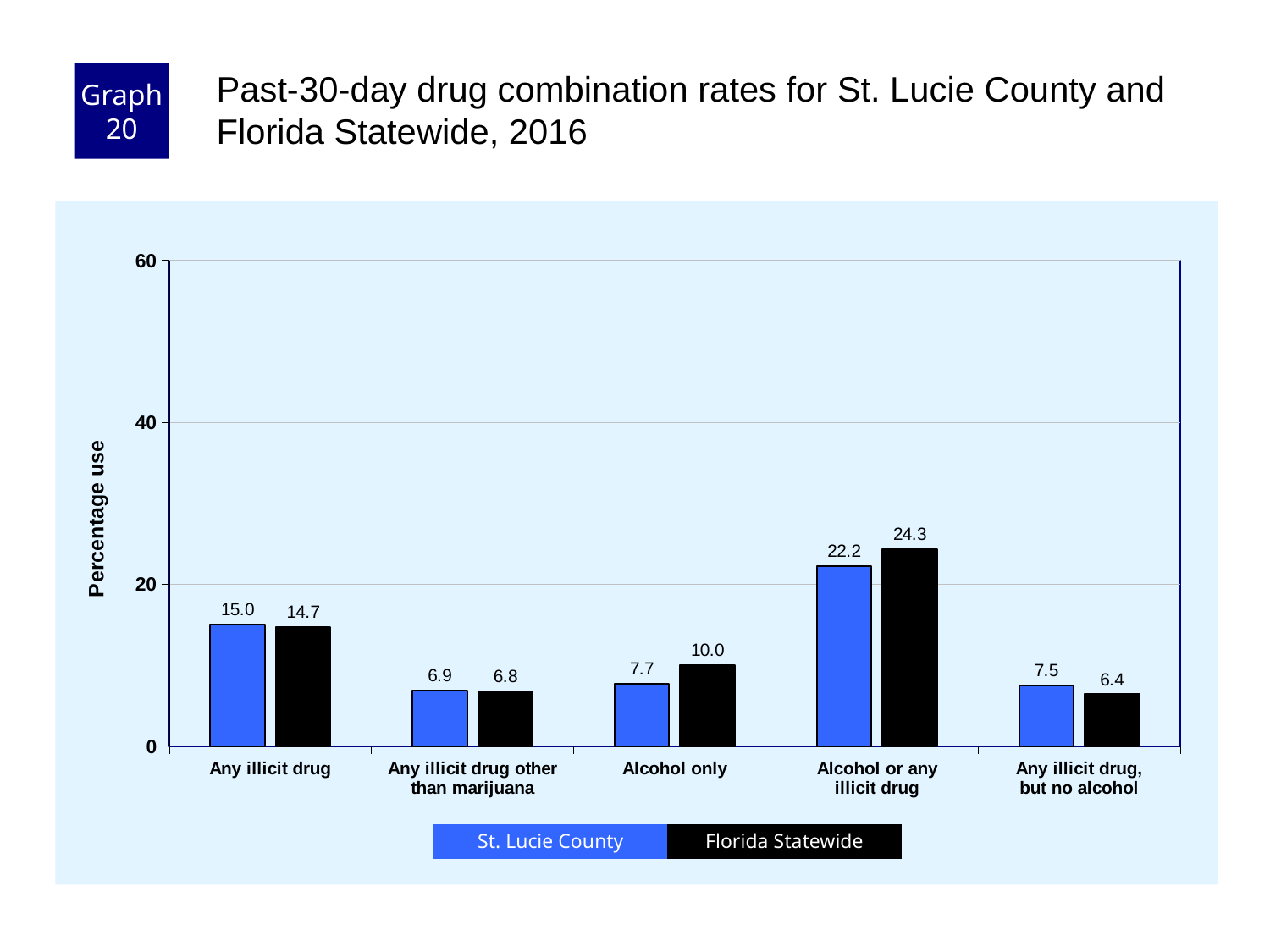
What is the difference between the Florida Statewide and St. Lucie County values for Alcohol or any illicit drug? 2.1 What kind of chart is shown on the slide? Bar chart What is the difference between the Florida Statewide and St. Lucie County values for Alcohol only? 2.3 How many categories are shown on the x axis? 5 What is the Florida Statewide value for Any illicit drug, but no alcohol? 6.4 Is the St. Lucie County value for Alcohol or any illicit drug greater or less than 20? greater Which category has the highest Florida Statewide value? Alcohol or any illicit drug Which category has the lowest St. Lucie County value? Any illicit drug other than marijuana For Any illicit drug, but no alcohol, which is larger: St. Lucie County or Florida Statewide? St. Lucie County What is the St. Lucie County value for Any illicit drug? 15.0 How many series does the legend list? 2 What is the Florida Statewide value for Alcohol only? 10.0